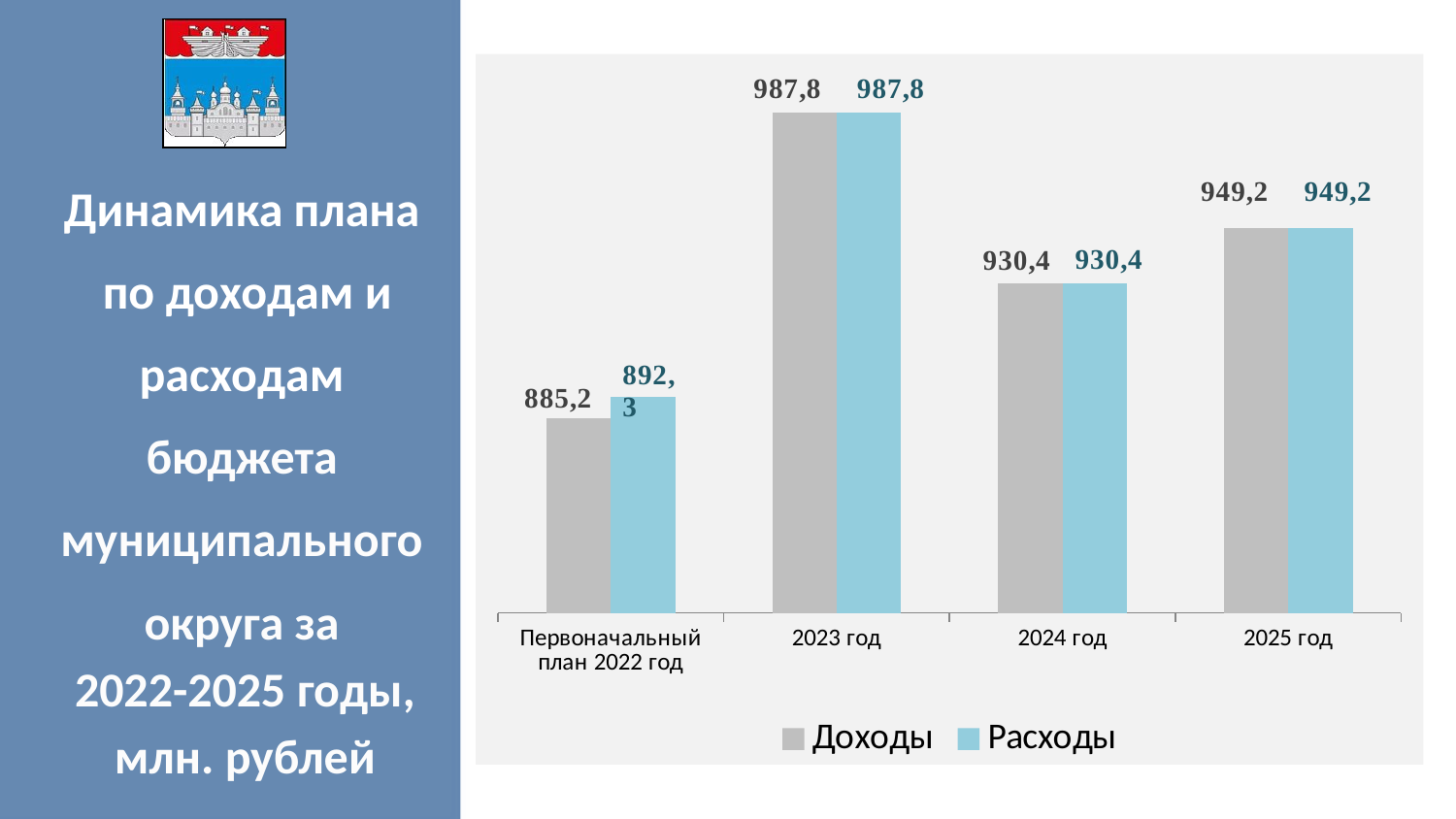
How many series does the legend list? 2 What is the difference between Доходы for 2023 год and Доходы for 2025 год? 38,6 What is the difference between Расходы and Доходы for Первоначальный план 2022 год? 7,1 What is the value of Расходы for Первоначальный план 2022 год? 892,3 What kind of chart is shown on the slide? bar chart Which is larger: Доходы for 2024 год or Доходы for 2025 год? 2025 год What is the value of Доходы for 2023 год? 987,8 How many categories are shown on the x axis? 4 Which category has the lowest value for Расходы? Первоначальный план 2022 год Which category has the highest value for Доходы? 2023 год What is the value of Доходы for 2025 год? 949,2 Do the Доходы values rise or fall from 2023 год to 2024 год? fall